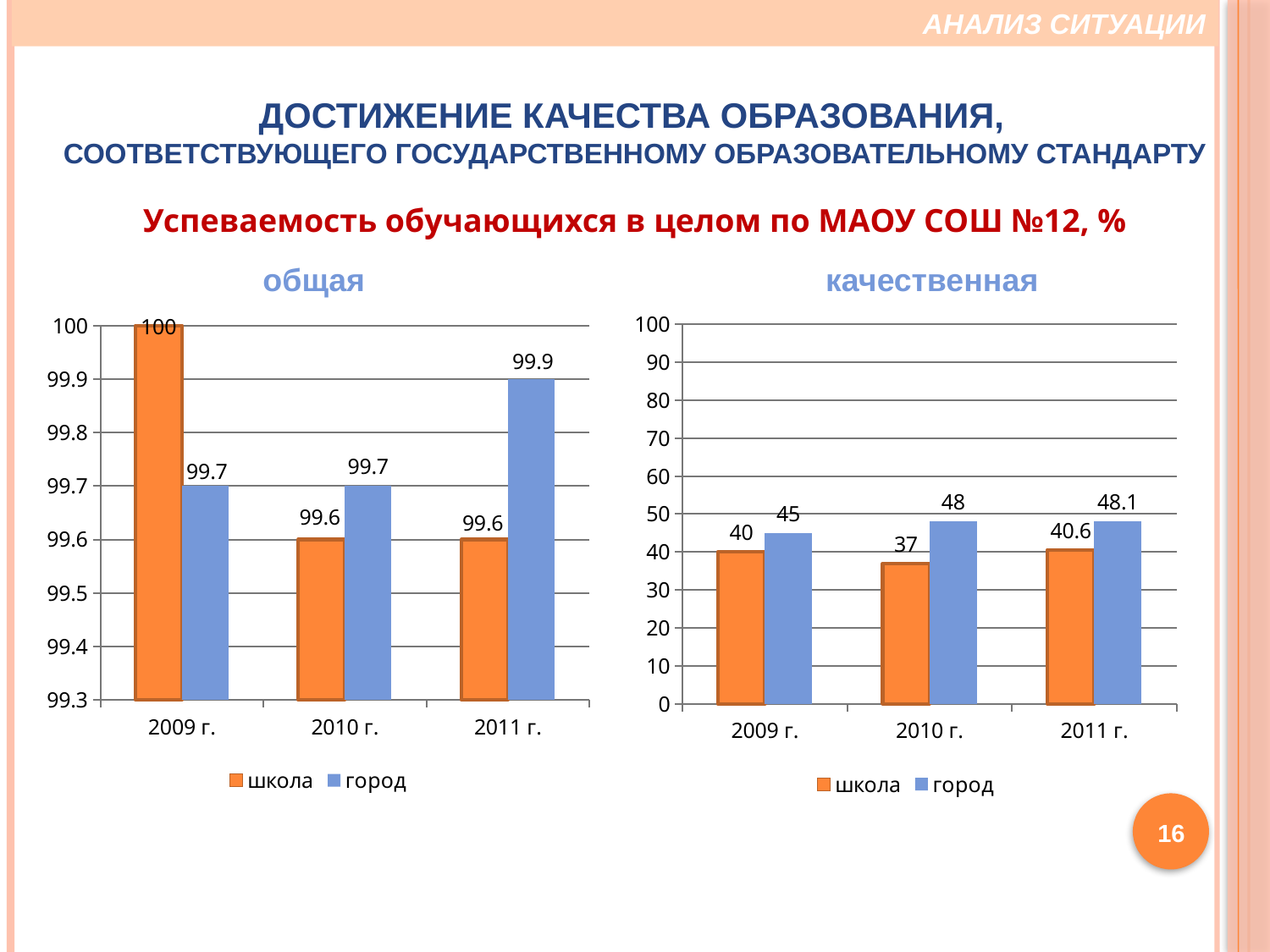
In the "качественная" chart, what is the difference between город and школа in 2009 г.? 5 In the "общая" chart, what is the value for школа in 2009 г.? 100 In the "качественная" chart, which year has the lowest value for школа? 2010 г. In the "качественная" chart, which is larger in 2011 г., школа or город? город What kind of chart is the "качественная" chart? bar chart In the "качественная" chart, what is the value for город in 2011 г.? 48.1 How many years are shown on the x axis of the "общая" chart? 3 In the "общая" chart, what is the value for город in 2011 г.? 99.9 In the "общая" chart, which year has the highest value for город? 2011 г. In the "общая" chart, what is the difference between школа and город in 2009 г.? 0.3 How many series does the legend of the "качественная" chart list? 2 In the "качественная" chart, what is the value for школа in 2010 г.? 37